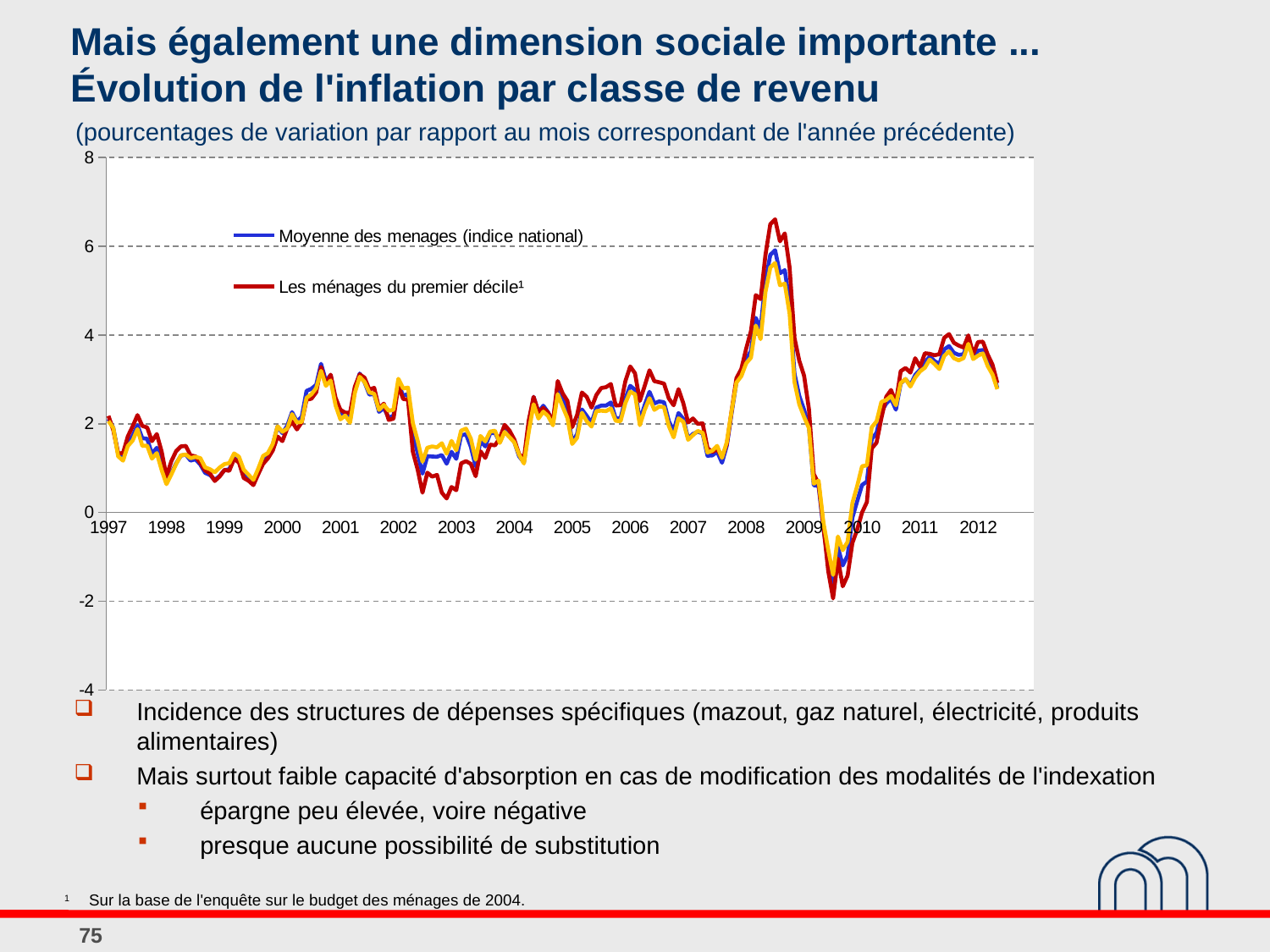
Do the lines rise or fall between the trough in 2009 and 2011? rise Is the lowest value of the 'Les ménages du premier décile' line in 2009 greater or less than 0? less What kind of chart is shown on the slide? line chart Is the lowest value of the 'Moyenne des menages (indice national)' line in 2009 greater or less than 0? less How many series does the chart legend list? 2 Do the lines rise or fall between the start of 2009 and the trough later in 2009? fall What colour is the line for 'Les ménages du premier décile' in the legend? red In which year does the 'Les ménages du premier décile' line reach its highest peak? 2008 How many year labels are shown on the x axis? 16 Is the peak value of the 'Les ménages du premier décile' line in 2008 greater or less than 6? greater In which year does the 'Les ménages du premier décile' line reach its lowest point? 2009 What are the two series named in the chart legend? Moyenne des menages (indice national); Les ménages du premier décile